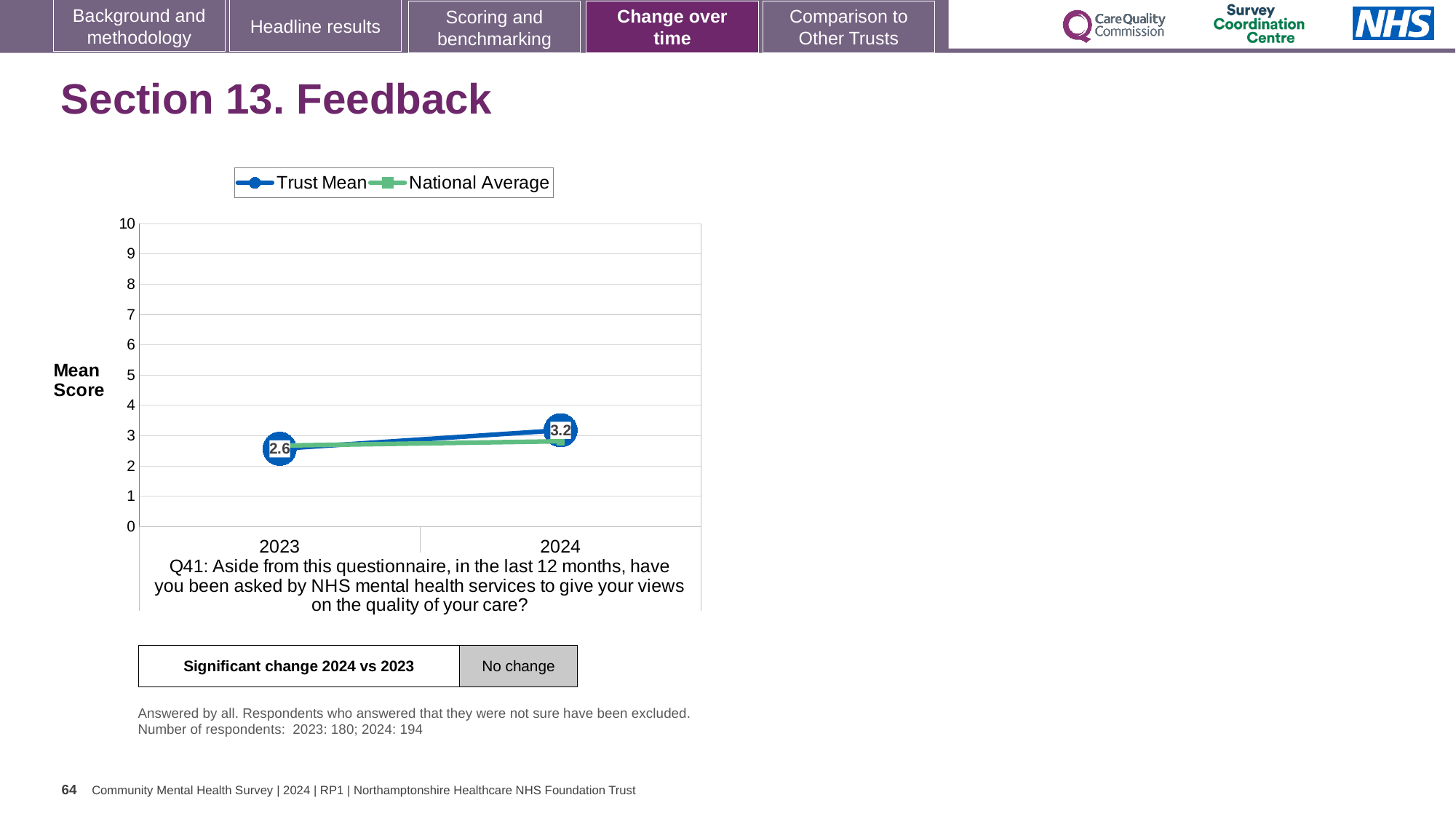
How many years are plotted on the x axis? 2 How many series does the legend list? 2 What is the label on the y axis of the chart? Mean Score By how much did the Trust Mean score change from 2023 to 2024? 0.6 Which year has the higher Trust Mean score, 2023 or 2024? 2024 Does the Trust Mean line rise or fall from 2023 to 2024? rise In 2024, which is higher, the Trust Mean or the National Average? Trust Mean What is the Trust Mean score for 2024? 3.2 What kind of chart is shown on the slide? line chart Is the National Average value for 2024 greater or less than 4? less Which year has the lowest Trust Mean score? 2023 What is the Trust Mean score for 2023? 2.6